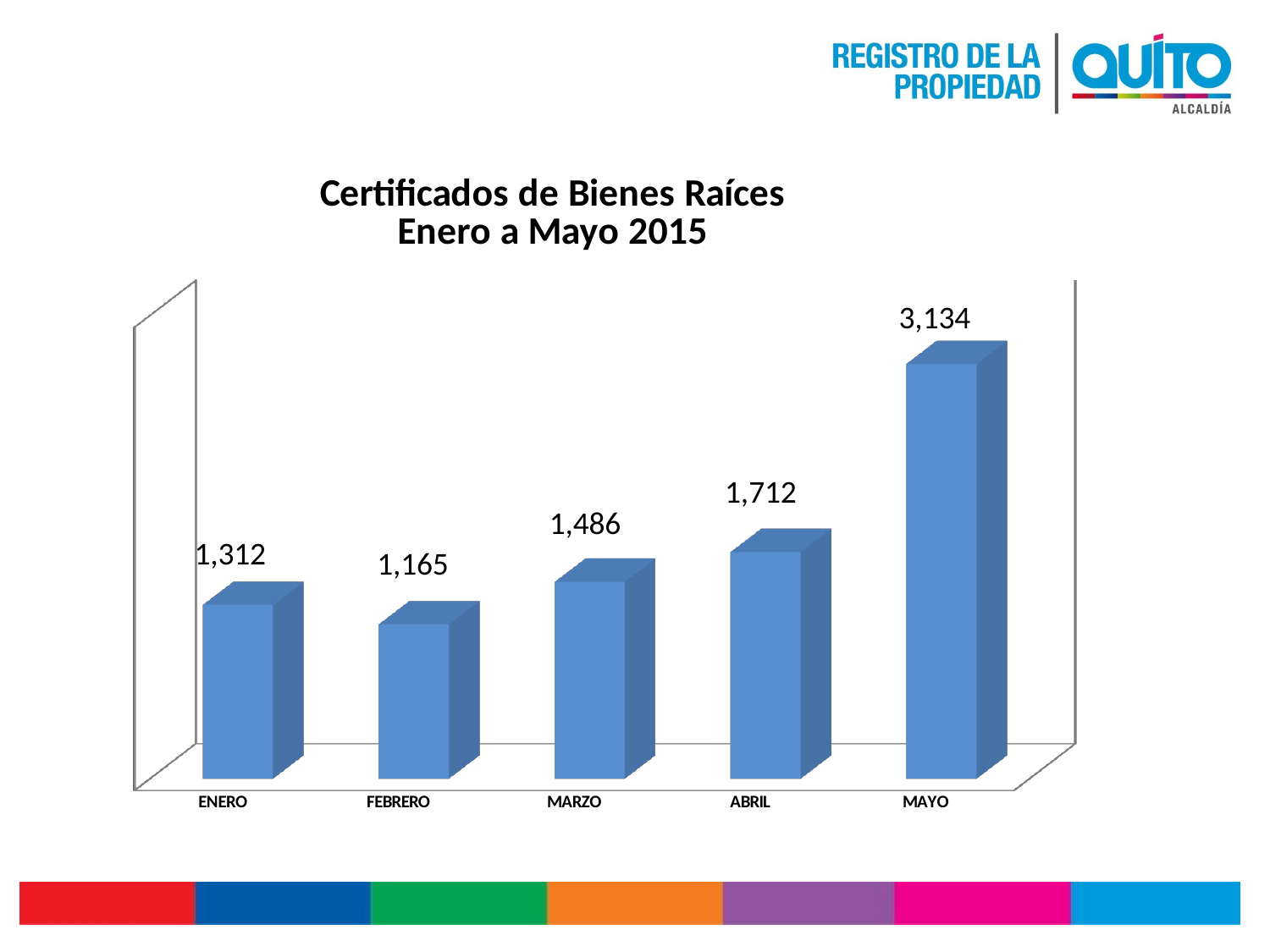
What is the title of the chart? Certificados de Bienes Raíces Enero a Mayo 2015 What is the value for MARZO? 1,486 What is the difference between the values for ENERO and FEBRERO? 147 Do the values rise or fall from FEBRERO to MAYO? rise Which month has the highest value? MAYO Which month has the lowest value? FEBRERO What is the value for FEBRERO? 1,165 Which is larger, the value for ABRIL or the value for MARZO? ABRIL What is the difference between the values for MAYO and ABRIL? 1,422 How many months are shown on the chart? 5 What kind of chart is shown on the slide? bar chart What is the value for MAYO? 3,134